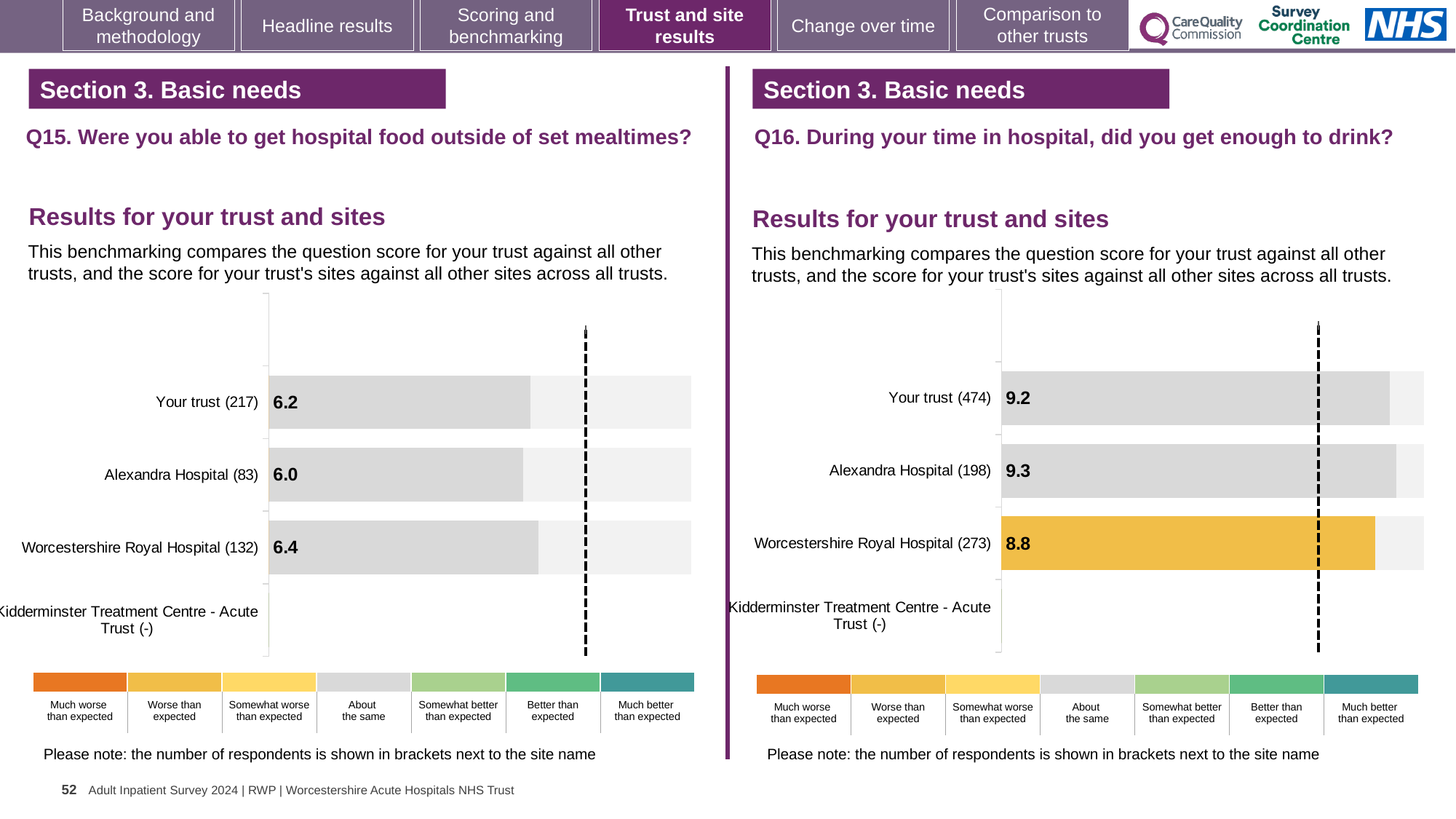
On the Q16 chart (right), how many respondents are shown in brackets for Your trust? 474 On the Q16 chart (right), what is the score for Worcestershire Royal Hospital? 8.8 On the Q16 chart (right), what is the difference between the scores for Alexandra Hospital and Worcestershire Royal Hospital? 0.5 On the Q16 chart (right), what is the score for Your trust? 9.2 On the Q16 chart (right), what is the score for Alexandra Hospital? 9.3 On the Q15 chart (left), what is the score for Worcestershire Royal Hospital? 6.4 On the Q15 chart (left), which site has the highest score? Worcestershire Royal Hospital On the Q16 chart (right), which site has the lowest score? Worcestershire Royal Hospital On the Q15 chart (left), what is the difference between the scores for Worcestershire Royal Hospital and Alexandra Hospital? 0.4 On the Q15 chart (left), what is the score for Alexandra Hospital? 6.0 On the Q15 chart (left), what is the score for Your trust? 6.2 What kind of chart is used on the Q15 chart (left)? Bar chart